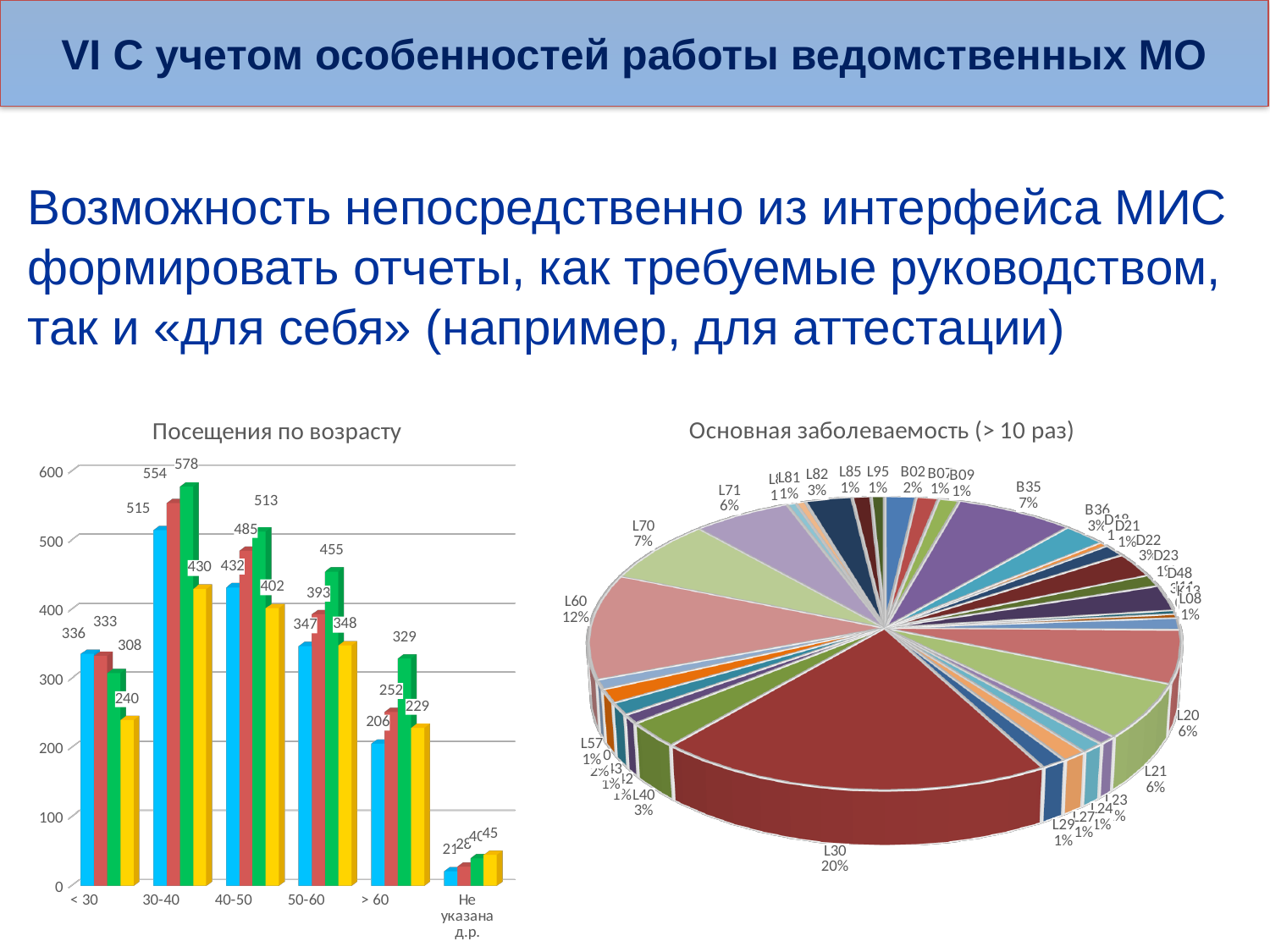
In the chart titled "Посещения по возрасту", which age category has the highest blue bar? 30-40 What kind of chart is the one on the right side of the slide? pie chart In the chart titled "Посещения по возрасту", what is the value of the yellow bar for the 40-50 category? 402 In the chart titled "Посещения по возрасту", what is the value of the green bar for the 30-40 category? 578 In the chart titled "Посещения по возрасту", what is the value of the blue bar for the < 30 category? 336 What kind of chart is the one titled "Посещения по возрасту"? bar chart In the chart titled "Посещения по возрасту", what is the difference between the green bar and the blue bar for the 50-60 category? 108 In the pie chart titled "Основная заболеваемость (> 10 раз)", what share does L30 have? 20% In the pie chart titled "Основная заболеваемость (> 10 раз)", which slice is the largest? L30 In the pie chart titled "Основная заболеваемость (> 10 раз)", what share does L60 have? 12% In the chart titled "Посещения по возрасту", which is larger for the > 60 category: the red bar or the yellow bar? the red bar In the chart titled "Посещения по возрасту", how many age categories are shown on the x axis? 6